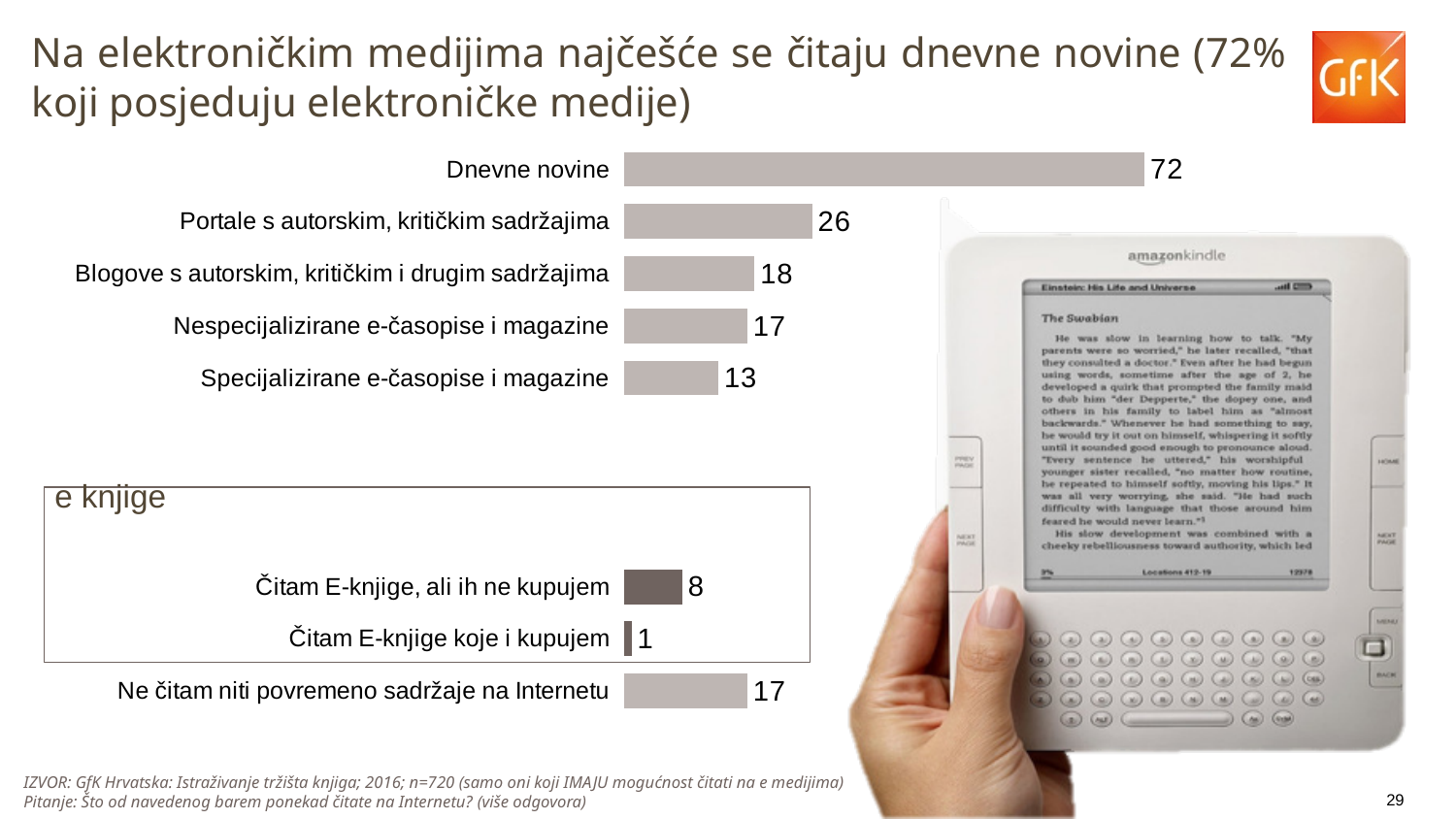
What kind of chart is shown on the slide? bar chart What is the difference between the values for Blogove s autorskim, kritičkim i drugim sadržajima and Specijalizirane e-časopise i magazine? 5 How many categories are shown in the chart? 8 What is the value for Portale s autorskim, kritičkim sadržajima? 26 What is the value for Čitam E-knjige, ali ih ne kupujem? 8 What is the value for Dnevne novine? 72 Which is larger, the value for Nespecijalizirane e-časopise i magazine or the value for Specijalizirane e-časopise i magazine? Nespecijalizirane e-časopise i magazine What is the difference between the values for Dnevne novine and Portale s autorskim, kritičkim sadržajima? 46 What is the value for Ne čitam niti povremeno sadržaje na Internetu? 17 Which two categories are grouped under the heading 'e knjige'? Čitam E-knjige, ali ih ne kupujem; Čitam E-knjige koje i kupujem Which category has the lowest value? Čitam E-knjige koje i kupujem Which category has the highest value? Dnevne novine